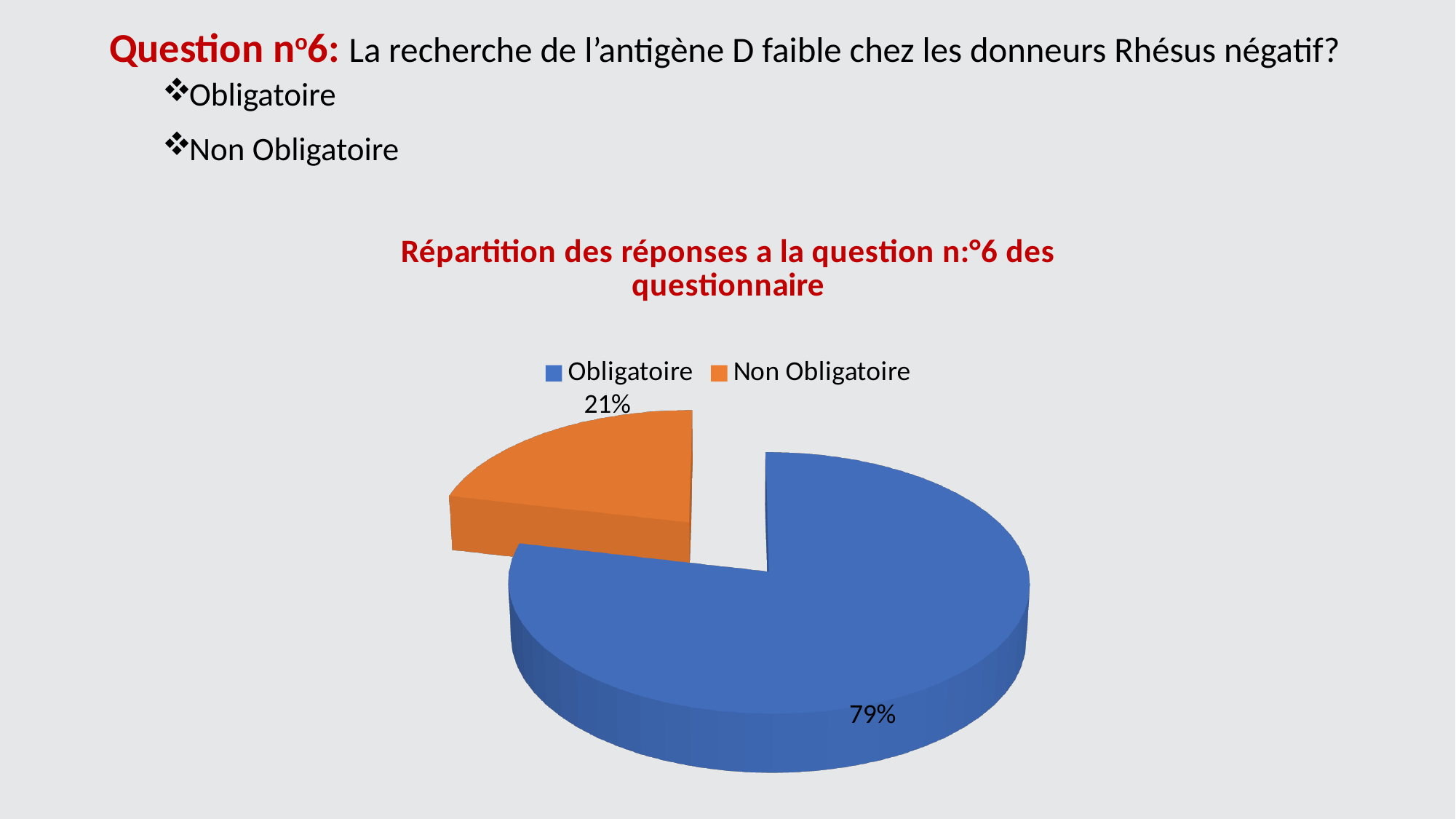
What percentage of responses are 'Obligatoire'? 79% What is the title of the chart? Répartition des réponses a la question n:°6 des questionnaire Which response category has the smallest share of the pie? Non Obligatoire What share of the pie does the 'Non Obligatoire' slice represent? 21% Which is larger, the 'Obligatoire' slice or the 'Non Obligatoire' slice? Obligatoire How many entries does the legend list? 2 What colour is the 'Non Obligatoire' slice? Orange What is the difference in percentage points between the 'Obligatoire' and 'Non Obligatoire' slices? 58 What percentage of responses are 'Non Obligatoire'? 21% What kind of chart is shown on the slide? Pie chart Which response category has the largest share of the pie? Obligatoire How many slices does the pie chart have? 2